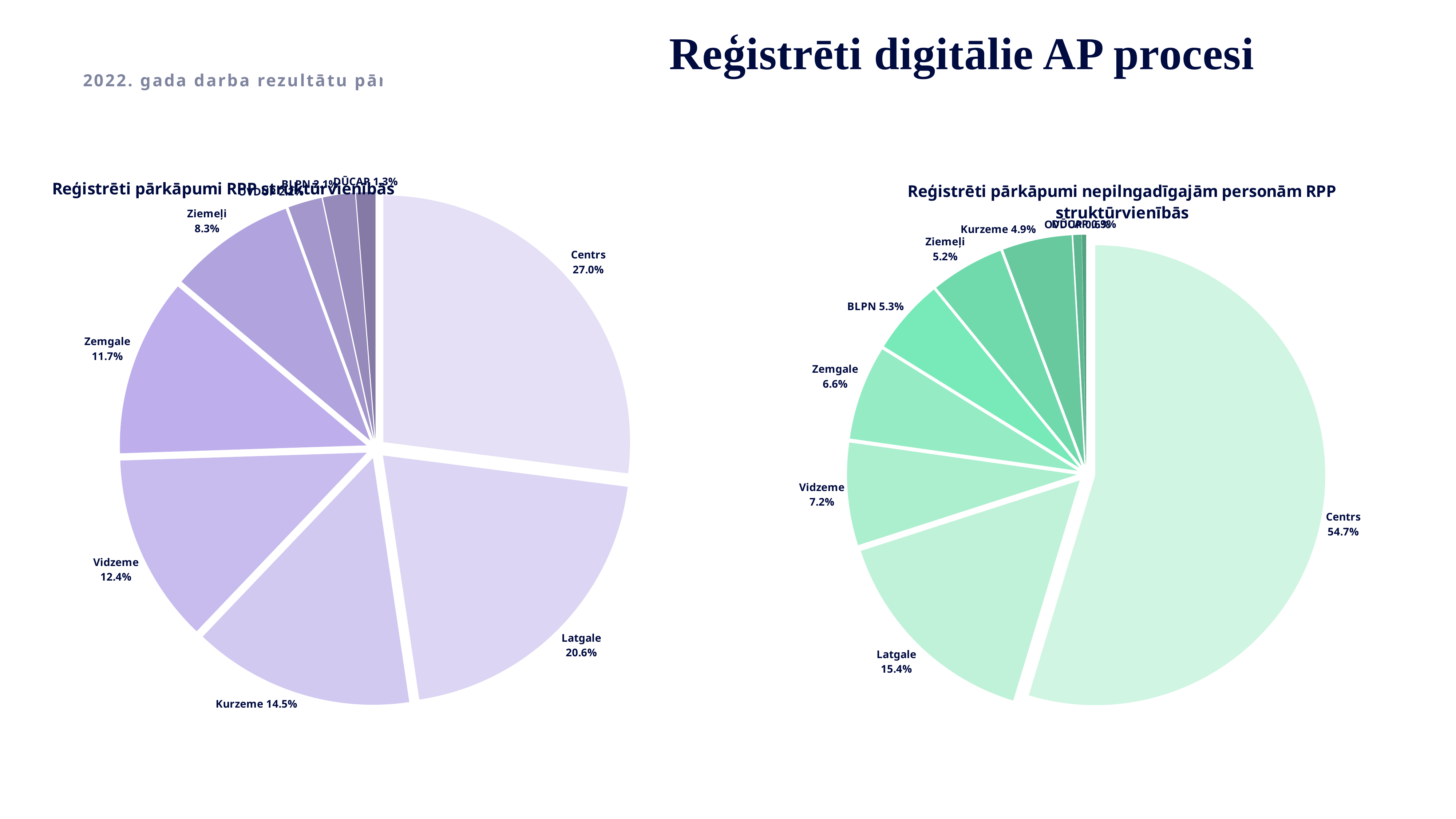
In the right chart, 'Reģistrēti pārkāpumi nepilngadīgajām personām RPP struktūrvienībās', what share does Centrs have? 54.7% What is the main title of the slide? Reģistrēti digitālie AP procesi In the left chart, 'Reģistrēti pārkāpumi RPP struktūrvienībās', what share does Latgale have? 20.6% What type of chart is the left chart, 'Reģistrēti pārkāpumi RPP struktūrvienībās'? Pie chart In the left chart, 'Reģistrēti pārkāpumi RPP struktūrvienībās', what is the difference between the shares of Kurzeme and Vidzeme? 2.1% In the left chart, 'Reģistrēti pārkāpumi RPP struktūrvienībās', which is larger: Zemgale or Ziemeļi? Zemgale In the right chart, 'Reģistrēti pārkāpumi nepilngadīgajām personām RPP struktūrvienībās', what share does Latgale have? 15.4% In the left chart, 'Reģistrēti pārkāpumi RPP struktūrvienībās', what share does Centrs have? 27.0% In the right chart, 'Reģistrēti pārkāpumi nepilngadīgajām personām RPP struktūrvienībās', what share does Kurzeme have? 4.9% In the right chart, 'Reģistrēti pārkāpumi nepilngadīgajām personām RPP struktūrvienībās', what is the difference between the shares of Centrs and Latgale? 39.3% In the left chart, 'Reģistrēti pārkāpumi RPP struktūrvienībās', which labelled unit has the largest share? Centrs In the right chart, 'Reģistrēti pārkāpumi nepilngadīgajām personām RPP struktūrvienībās', which is larger: Vidzeme or Zemgale? Vidzeme